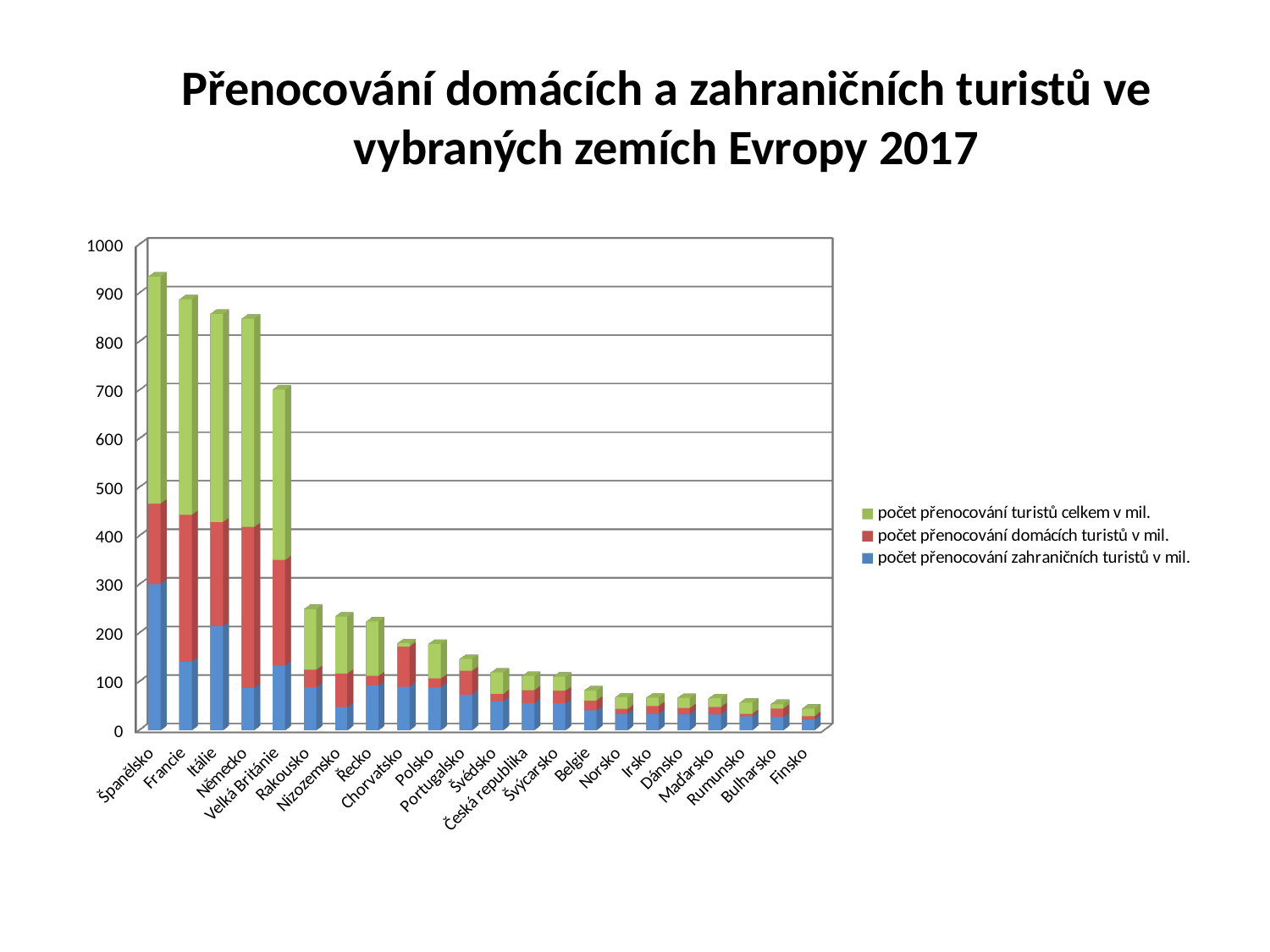
Which country has the tallest stacked bar? Španělsko Which series is shown in green in the legend? počet přenocování turistů celkem v mil. Is the top of the stacked bar for Chorvatsko greater or less than 200? less How many countries are shown on the x axis of the chart? 22 Do the stacked bar heights rise or fall moving from left to right along the x axis? fall How many series does the legend list? 3 Is the top of the stacked bar for Španělsko greater or less than 900? greater Which has the taller stacked bar, Španělsko or Francie? Španělsko Which country has the shortest stacked bar? Finsko What kind of chart is shown on the slide? stacked bar chart Is the blue segment (počet přenocování zahraničních turistů v mil.) for Itálie greater or less than 200? greater